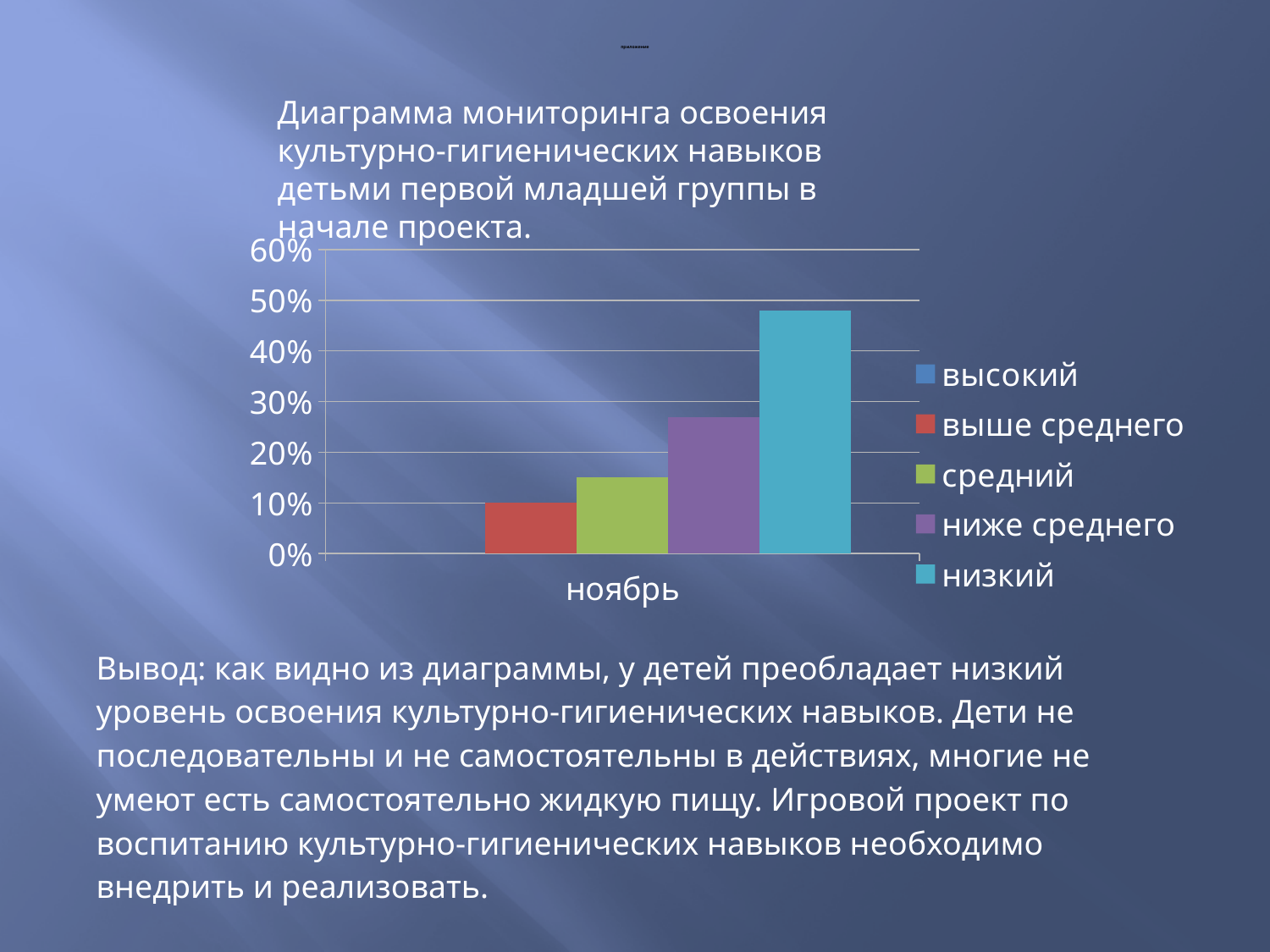
How many categories are shown on the x axis? 1 Is the value for низкий greater or less than 40%? greater Which is larger, the value for низкий or the value for ниже среднего? низкий What is the category label shown on the x axis? ноябрь What is the highest value shown on the y axis? 60% Is the value for ниже среднего greater or less than 30%? less How many series does the legend list? 5 Is the value for средний greater or less than 20%? less Which is larger, the value for средний or the value for выше среднего? средний Which series has the tallest bar? низкий What kind of chart is shown on the slide? bar chart